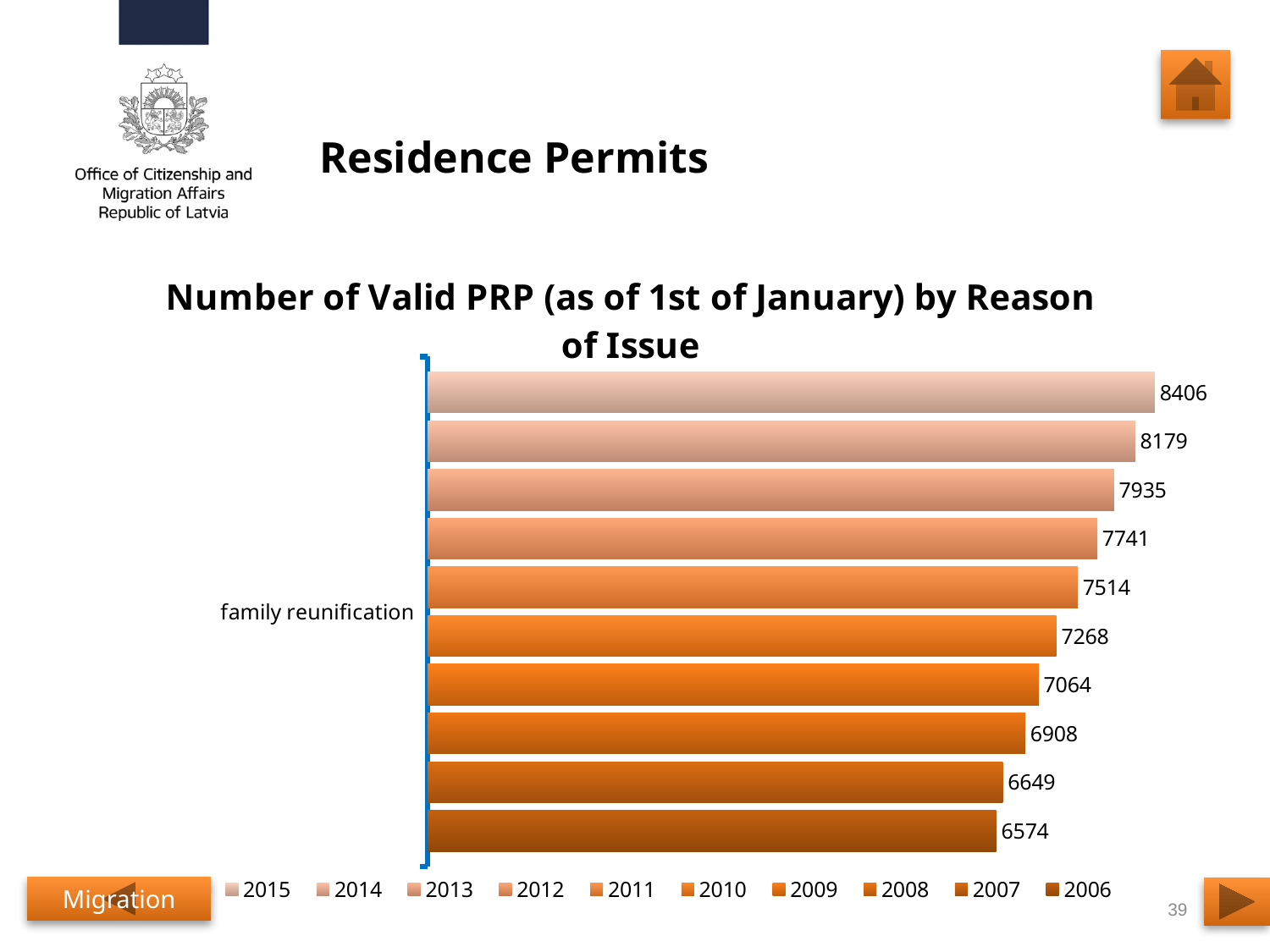
What is the number of valid PRP for family reunification in 2006? 6574 What is the number of valid PRP for family reunification in 2015? 8406 Which is larger, the value for 2013 or the value for 2009? 2013 Which year has the lowest number of valid PRP for family reunification? 2006 What is the value shown for 2011 in the family reunification chart? 7514 What is the difference between the 2010 and 2006 values for family reunification? 694 What is the difference between the 2015 and 2014 values for family reunification? 227 What kind of chart is shown on the slide? Bar chart How many series does the legend list? 10 Which year has the highest number of valid PRP for family reunification? 2015 What is the value shown for 2008 in the family reunification chart? 6908 What is the title of the chart? Number of Valid PRP (as of 1st of January) by Reason of Issue